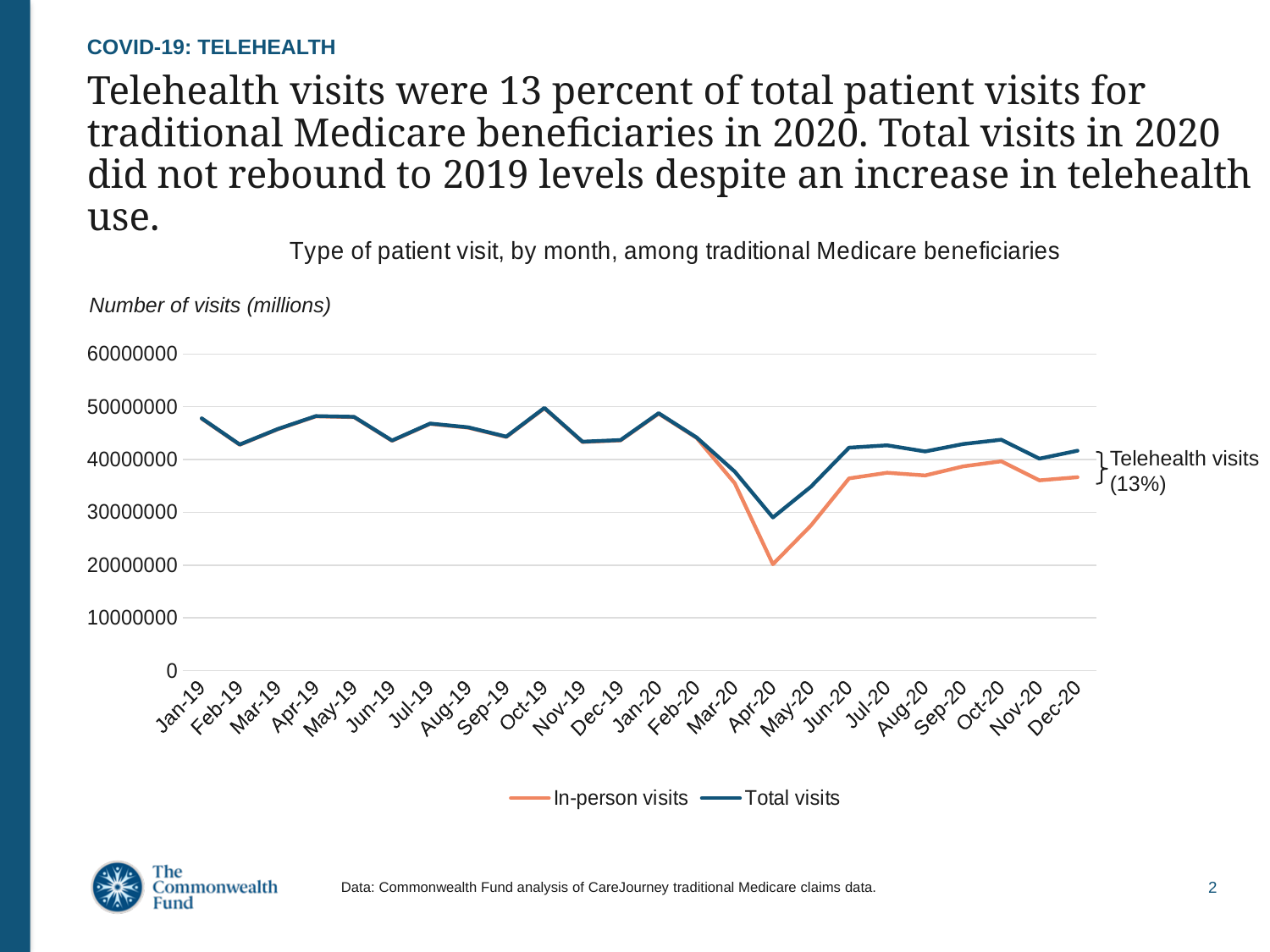
Which is larger, Total visits in Jan-19 or Total visits in Feb-19? Jan-19 Is the value for Total visits in Jan-19 greater or less than 50000000? less How many series does the legend list? 2 What kind of chart is shown on the slide? Line chart Is the value for In-person visits in Jun-20 greater or less than 30000000? greater In which month is the In-person visits line at its lowest? Apr-20 Is the value for In-person visits in Dec-20 greater or less than 40000000? less In which month is the Total visits line at its lowest? Apr-20 How many months are plotted along the x axis? 24 What are the two series named in the legend? In-person visits and Total visits Do Total visits rise or fall from Jan-20 to Apr-20? Fall What is the title of the chart? Type of patient visit, by month, among traditional Medicare beneficiaries